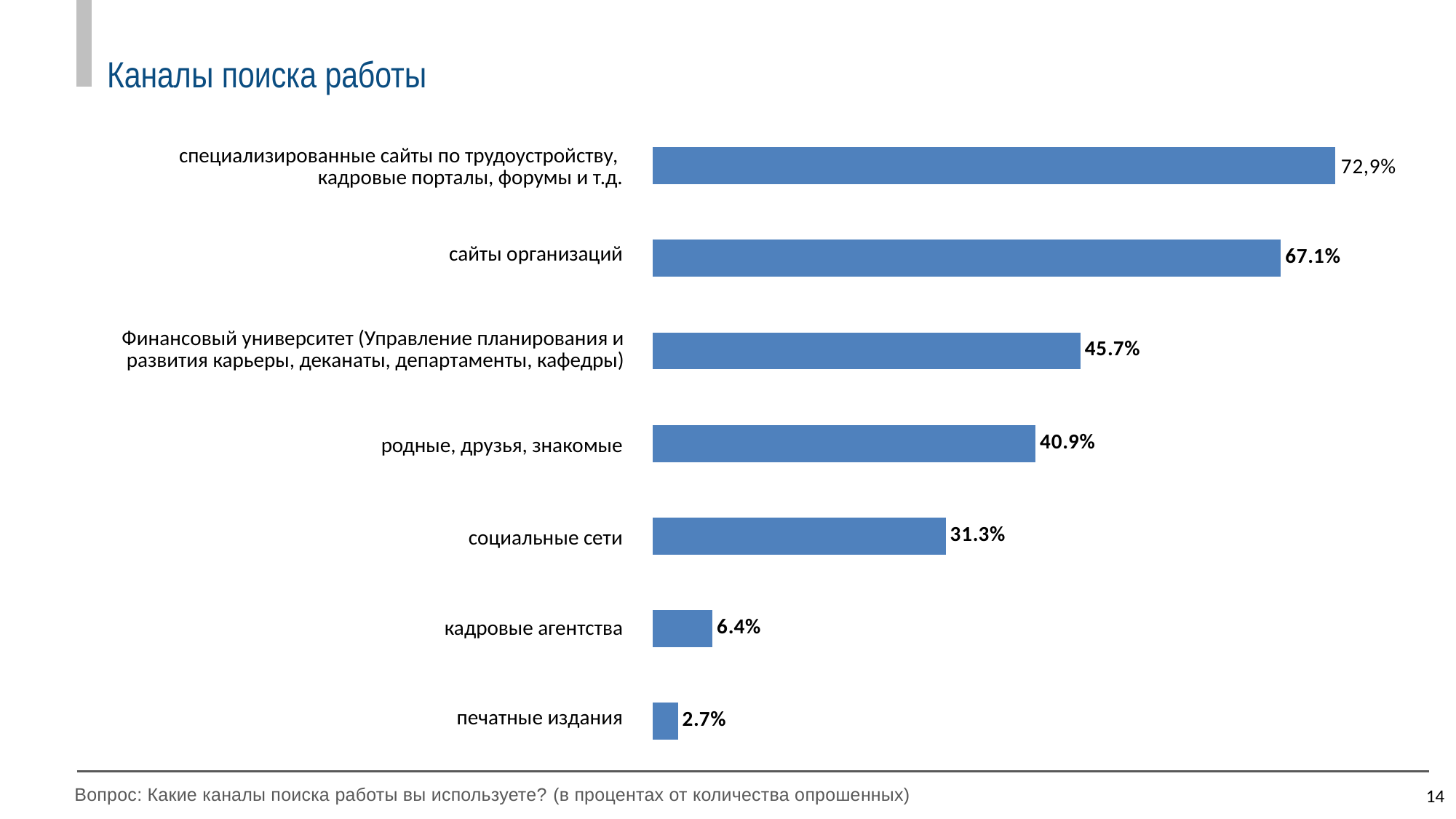
What is the difference between «родные, друзья, знакомые» and «социальные сети»? 9.6% What is the value for «социальные сети»? 31.3% Which category has the highest value? специализированные сайты по трудоустройству, кадровые порталы, форумы и т.д. What is the value for «кадровые агентства»? 6.4% What kind of chart is shown on the slide? bar chart What is the value for «специализированные сайты по трудоустройству, кадровые порталы, форумы и т.д.»? 72,9% What is the value for «сайты организаций»? 67.1% Which is larger: «Финансовый университет (Управление планирования и развития карьеры, деканаты, департаменты, кафедры)» or «родные, друзья, знакомые»? Финансовый университет (Управление планирования и развития карьеры, деканаты, департаменты, кафедры) Which category has the lowest value? печатные издания How many categories are shown in the chart? 7 What is the difference between «кадровые агентства» and «печатные издания»? 3.7% What is the title of the slide? Каналы поиска работы